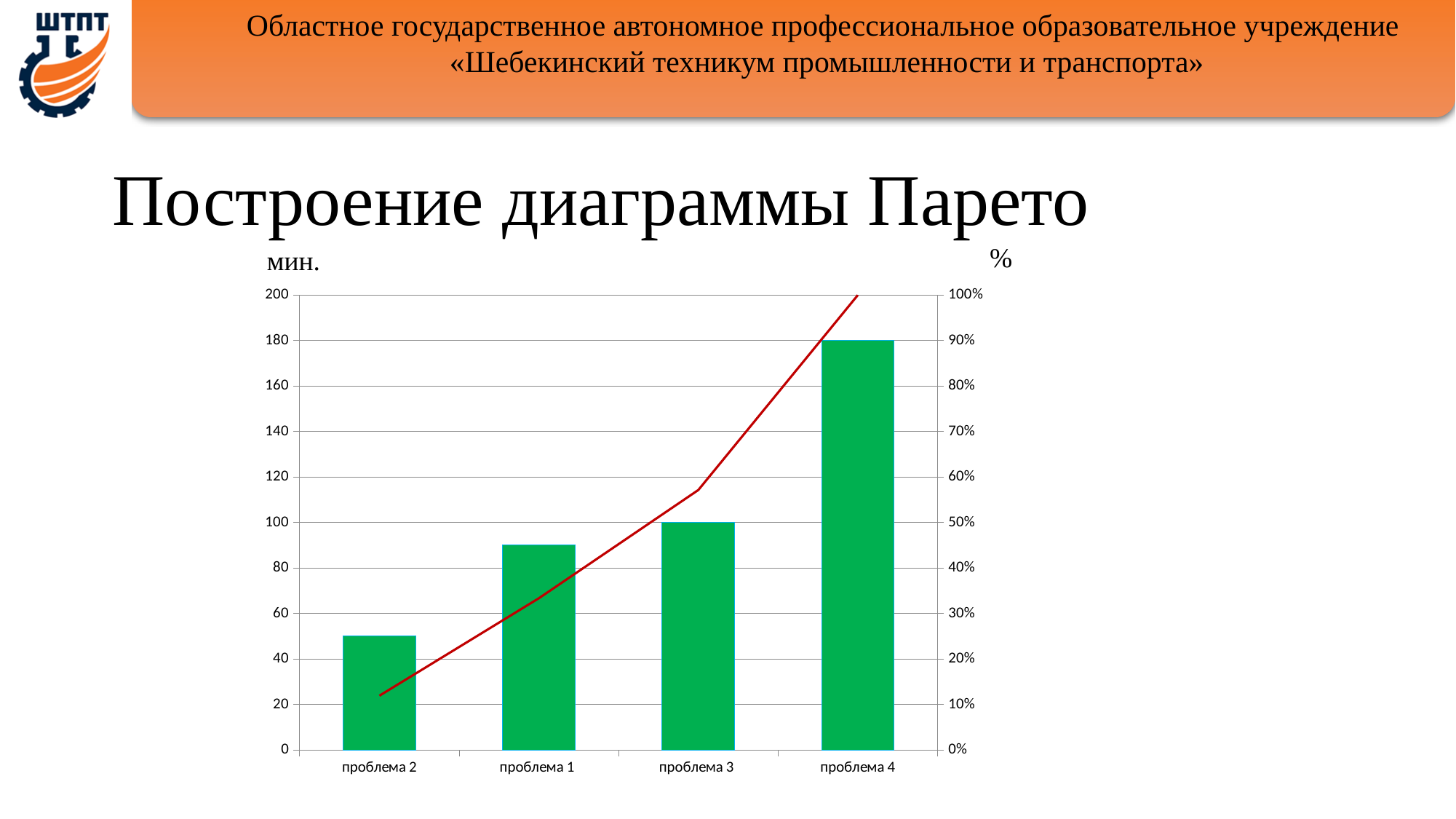
Which category has the shortest bar? проблема 2 Is the bar value for проблема 2 greater or less than 60? less What is the bar value (мин.) for проблема 3? 100 Is the bar value for проблема 1 greater or less than 80? greater Does the red line rise or fall from проблема 2 to проблема 4? rises What unit is labelled on the left vertical axis of the chart? мин. How many categories are shown on the x axis of the chart? 4 What is the bar value (мин.) for проблема 4? 180 Which bar is taller, проблема 2 or проблема 1? проблема 1 What kind of chart is shown on the slide? bar chart with a line Which category has the tallest bar? проблема 4 What is the difference between the bar values for проблема 4 and проблема 3? 80